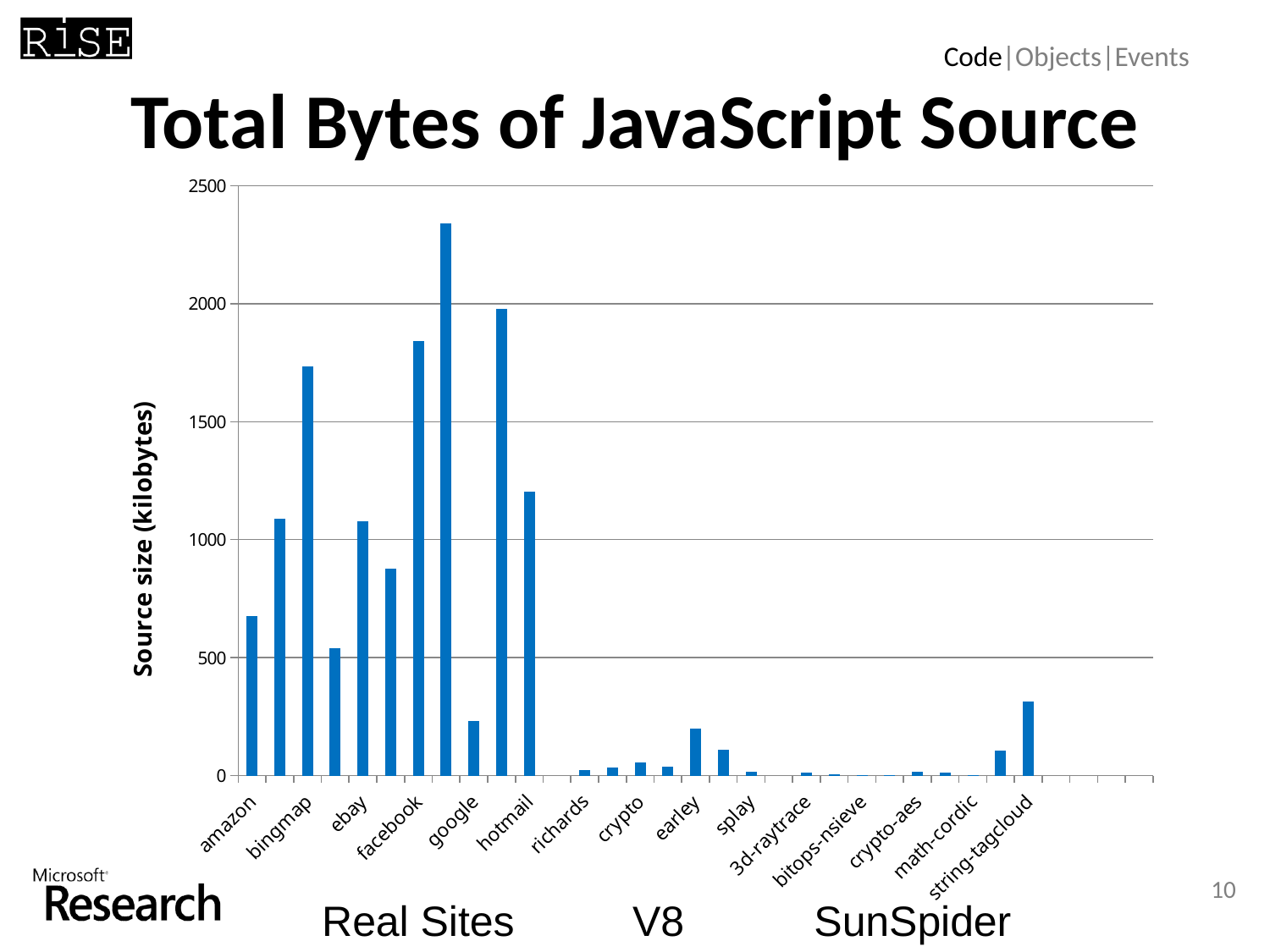
Which has the larger source size, facebook or google? facebook Is the value for string-tagcloud greater or less than 500? less What is the title of the chart? Total Bytes of JavaScript Source What kind of chart is shown on the slide? bar chart Is the value for bingmap greater or less than 1500? greater Is the value for amazon greater or less than 500? greater What is the label on the vertical axis? Source size (kilobytes) How many benchmark groups are labeled below the x axis (Real Sites, V8, SunSpider)? 3 Which has the larger source size, hotmail or earley? hotmail Which has the larger source size, string-tagcloud or richards? string-tagcloud